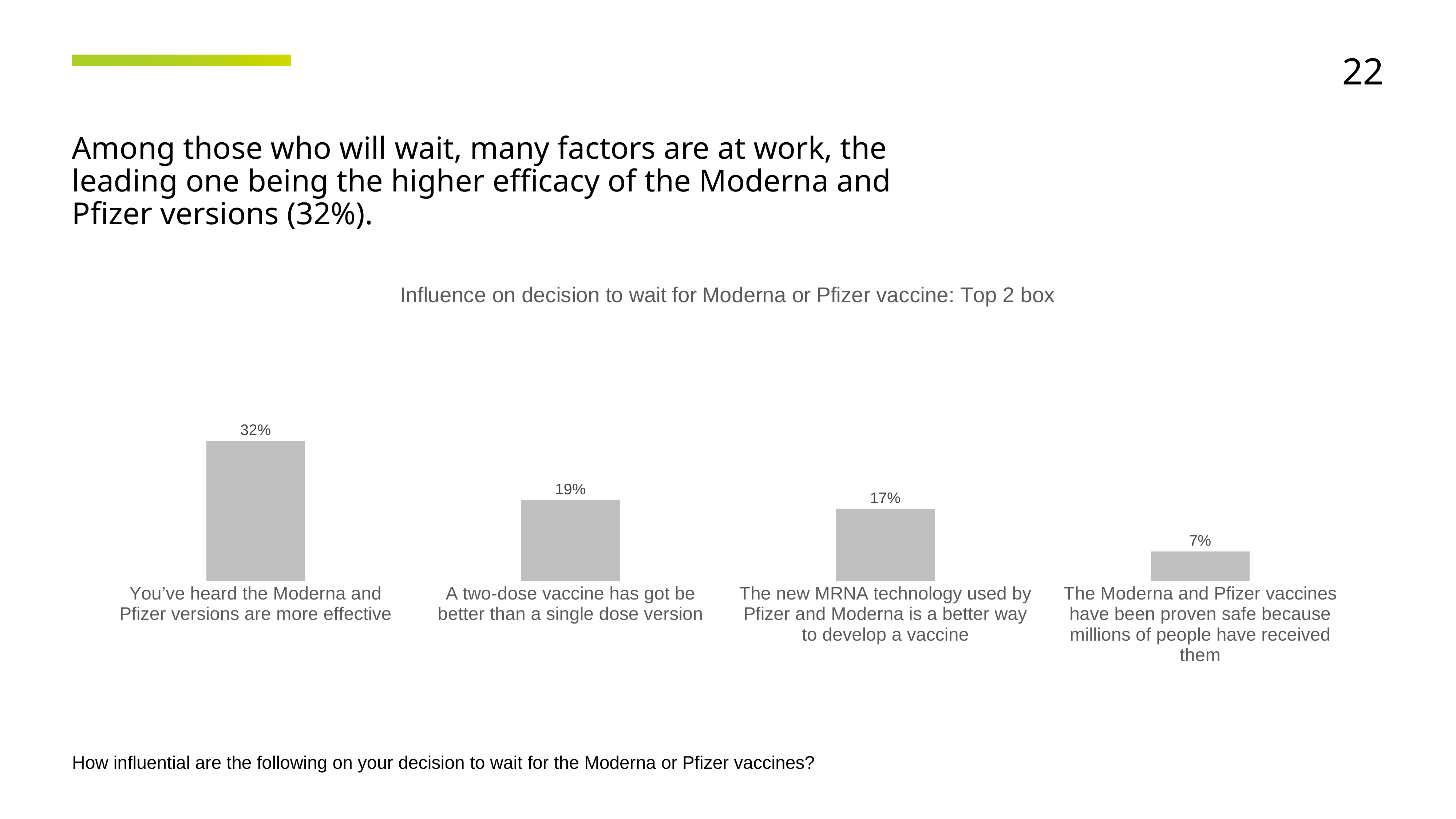
What is the difference between the value for "The new MRNA technology used by Pfizer and Moderna is a better way to develop a vaccine" and the value for "The Moderna and Pfizer vaccines have been proven safe because millions of people have received them"? 10% What is the difference between the value for "You've heard the Moderna and Pfizer versions are more effective" and the value for "A two-dose vaccine has got be better than a single dose version"? 13% What is the value for "A two-dose vaccine has got be better than a single dose version"? 19% What is the value for "You've heard the Moderna and Pfizer versions are more effective"? 32% What is the value for "The new MRNA technology used by Pfizer and Moderna is a better way to develop a vaccine"? 17% Which is larger: the value for "A two-dose vaccine has got be better than a single dose version" or the value for "The new MRNA technology used by Pfizer and Moderna is a better way to develop a vaccine"? A two-dose vaccine has got be better than a single dose version What is the value for "The Moderna and Pfizer vaccines have been proven safe because millions of people have received them"? 7% What kind of chart is shown on the slide? Bar chart Which category has the lowest value? The Moderna and Pfizer vaccines have been proven safe because millions of people have received them How many categories are shown in the chart? 4 What is the title of the chart? Influence on decision to wait for Moderna or Pfizer vaccine: Top 2 box Which category has the highest value? You've heard the Moderna and Pfizer versions are more effective